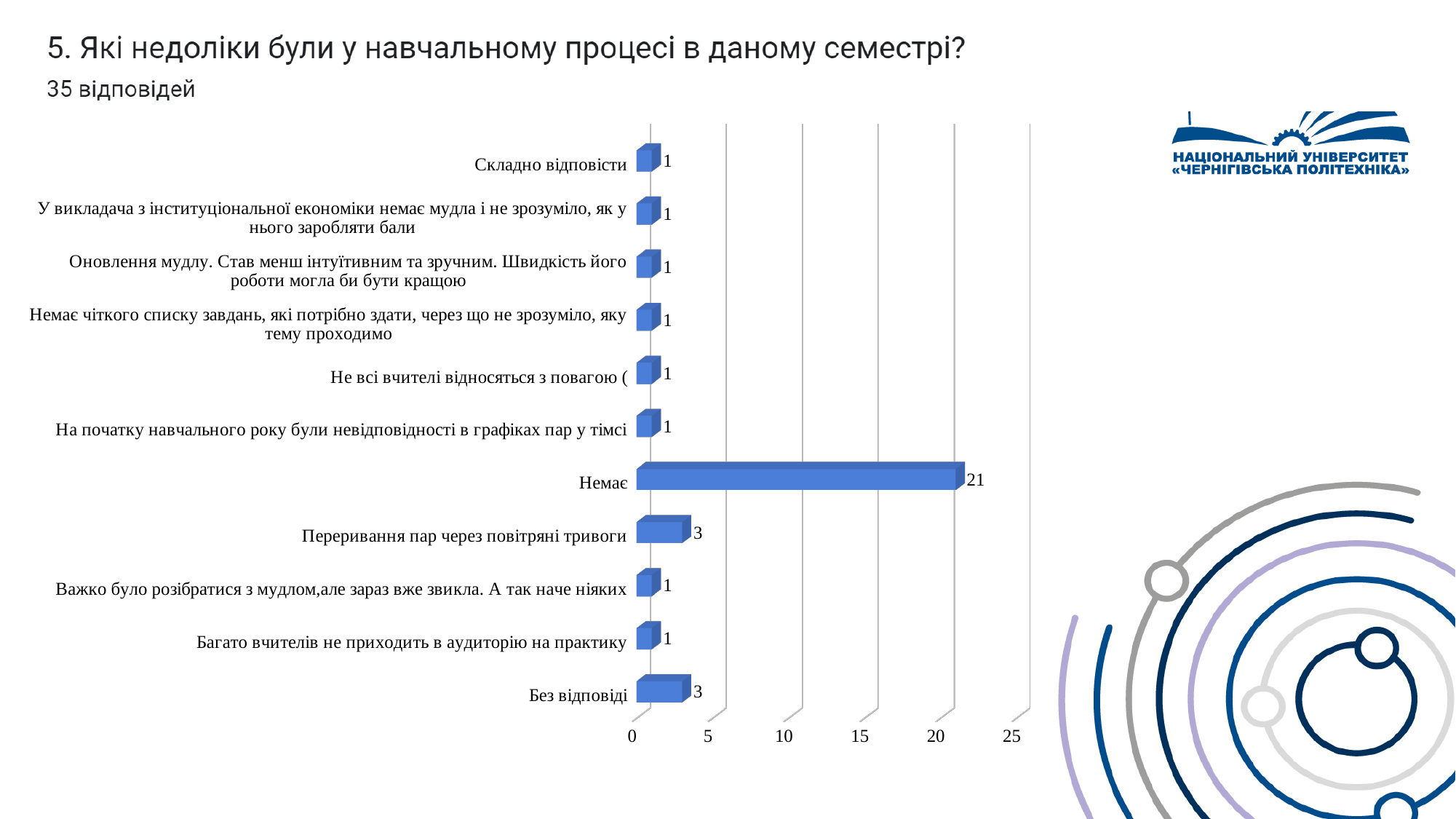
What type of chart is shown on the slide? bar chart Is the value for "Немає" greater or less than 20? greater What is the value for "Без відповіді"? 3 Which category has the highest value? Немає How many categories does the chart show? 11 What is the value for "Немає"? 21 What is the value for "Переривання пар через повітряні тривоги"? 3 How many responses does the slide say the question received? 35 відповідей What is the value for "Складно відповісти"? 1 Which is larger: the value for "Без відповіді" or the value for "Багато вчителів не приходить в аудиторію на практику"? Без відповіді What is the difference between the values for "Немає" and "Переривання пар через повітряні тривоги"? 18 How many categories have a value of 1? 8